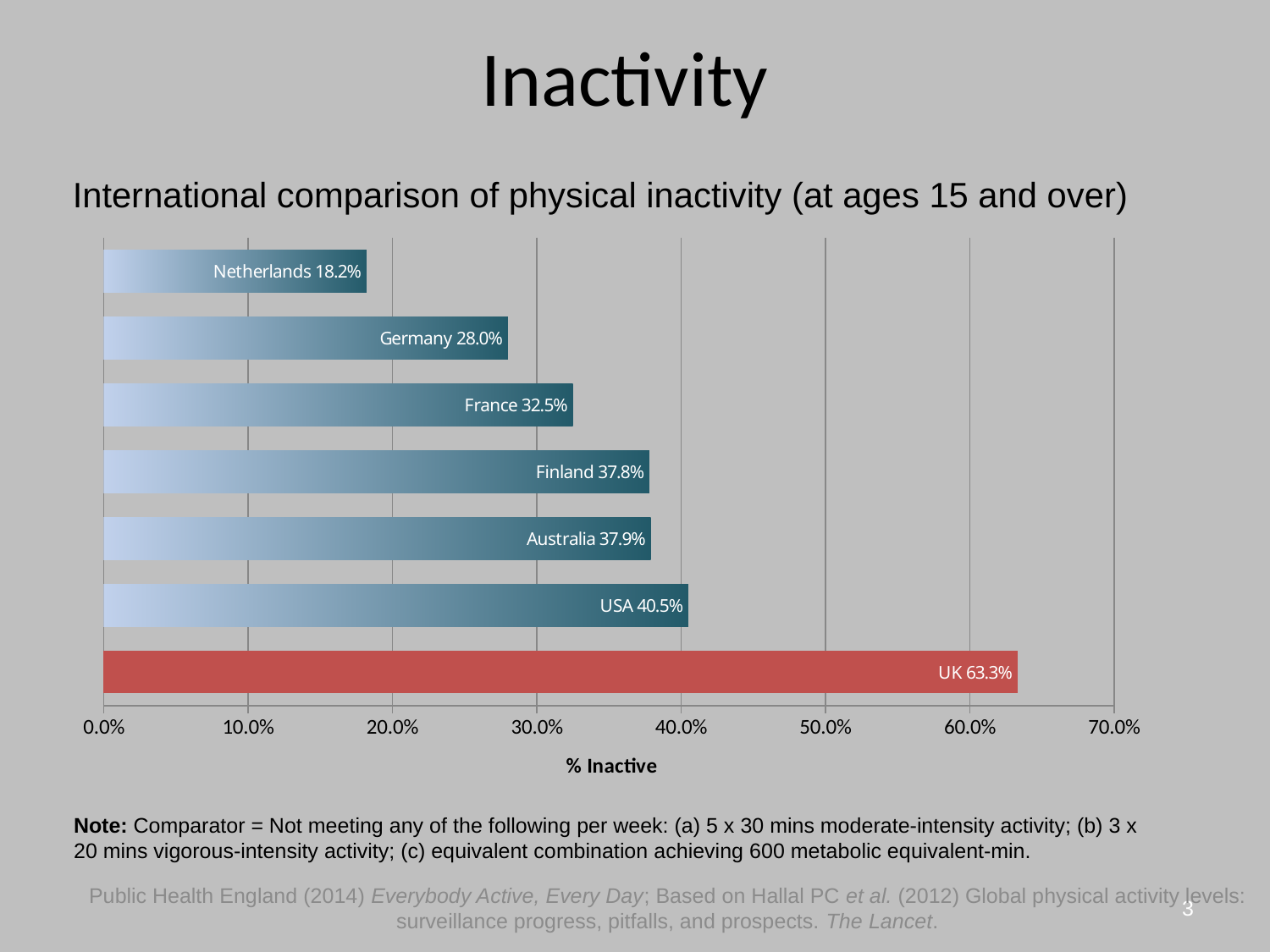
Which country has the highest percentage of physical inactivity? UK What is the percentage of physical inactivity shown for the UK? 63.3% What is the label on the horizontal axis of the chart? % Inactive What kind of chart is shown on the slide? Bar chart What is the difference in percentage points between Finland and the Netherlands inactivity values? 19.6 What is the percentage of physical inactivity shown for Germany? 28.0% How many countries are shown in the chart? 7 Which country has the lowest percentage of physical inactivity? Netherlands Which has a higher inactivity percentage, France or Germany? France Is the value for the USA greater or less than 40.0%? greater What is the percentage of physical inactivity shown for France? 32.5% What is the difference in percentage points between the UK and the USA inactivity values? 22.8